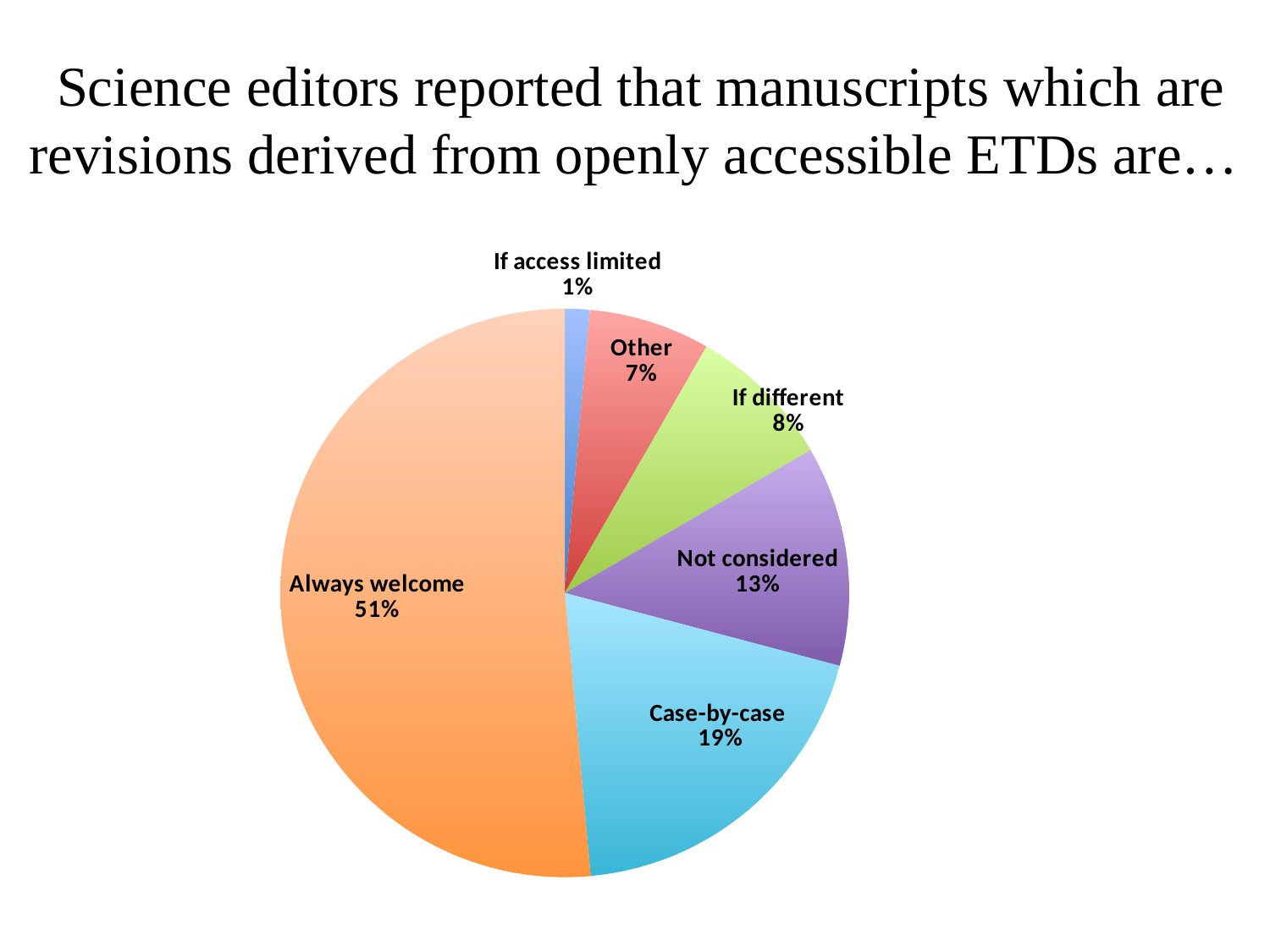
What is the value for 'Not considered'? 13% What share of the pie is labelled 'Case-by-case'? 19% What kind of chart is shown on the slide? pie chart What is the value for 'If different'? 8% Which is larger, 'Not considered' or 'If different'? Not considered What is the value for 'Other'? 7% What percentage of science editors reported that such manuscripts are always welcome? 51% What colour is the 'Always welcome' slice? orange Which category has the largest slice of the pie? Always welcome Which category has the smallest slice of the pie? If access limited How many slices does the pie chart have? 6 What is the difference in percentage points between 'Always welcome' and 'Case-by-case'? 32